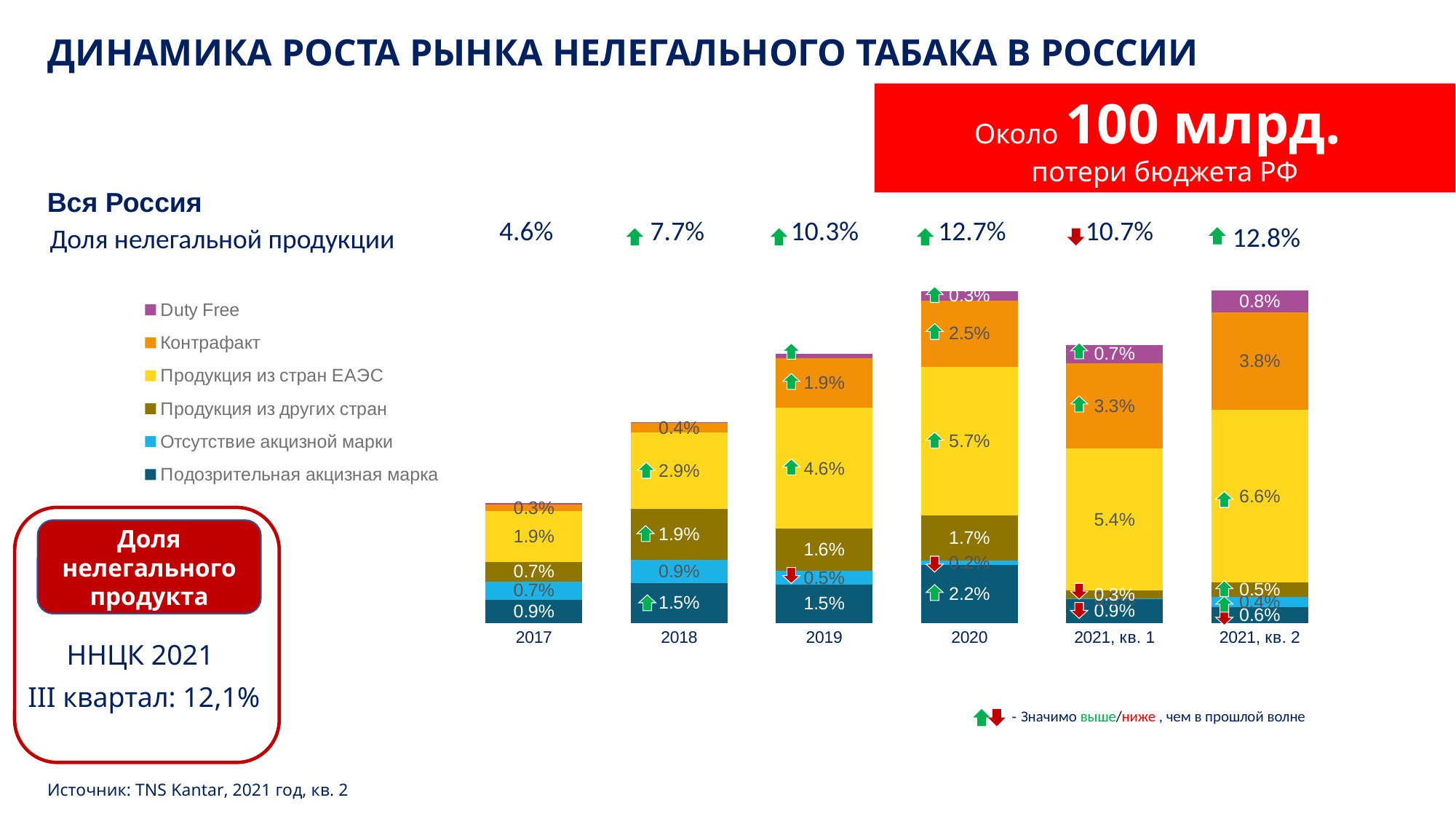
What is the value for Продукция из стран ЕАЭС in 2020? 5.7% How many periods (bars) are shown along the x axis of the chart? 6 How many series does the chart legend list? 6 What kind of chart is shown on the slide? Stacked bar chart Does the total share of illegal products rise or fall from 2017 to 2020? Rises What is the value for Контрафакт in 2021, кв. 2? 3.8% What is the value for Подозрительная акцизная марка in 2020? 2.2% What is the value for Продукция из других стран in 2019? 1.6% What is the difference between the Контрафакт values for 2021, кв. 2 and 2021, кв. 1? 0.5% Which period has the lowest total share of illegal products? 2017 What is the total share of illegal products (Доля нелегальной продукции) for 2021, кв. 2? 12.8% Which period has the highest total share of illegal products? 2021, кв. 2